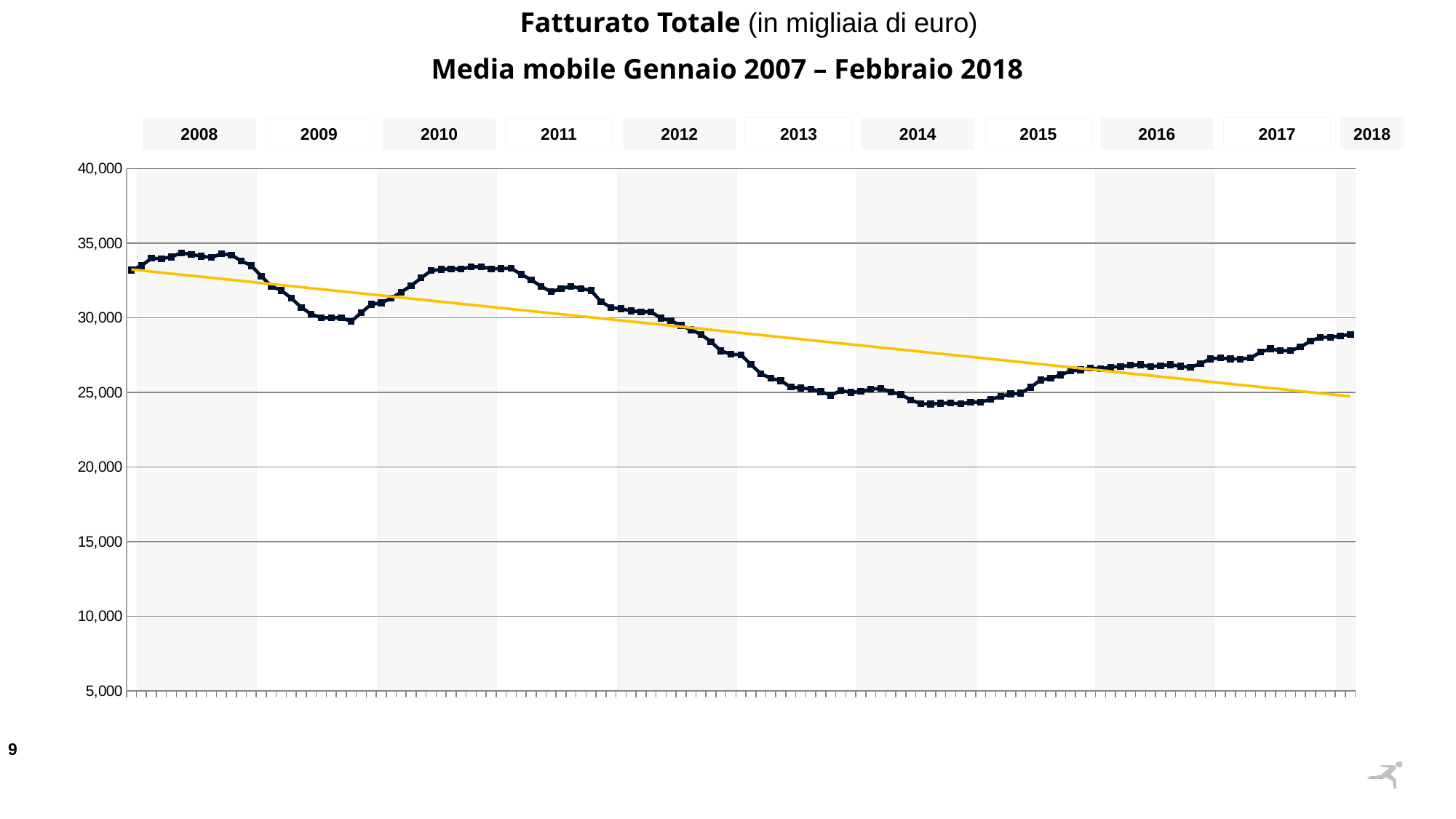
Which is higher, the moving average in 2014 or in 2010? 2010 Is the value of the moving average during 2010 greater or less than 30,000? greater Is the value of the moving average during 2016 greater or less than 30,000? less Is the value of the moving average during 2008 greater or less than 30,000? greater Which is higher, the moving average in 2008 or in 2016? 2008 What is the title of the chart? Fatturato Totale (in migliaia di euro) – Media mobile Gennaio 2007 – Febbraio 2018 Does the orange trend line rise or fall from left to right? fall How many year labels are shown above the chart? 11 What kind of chart is shown on the slide? line chart What is the highest value shown on the vertical axis? 40,000